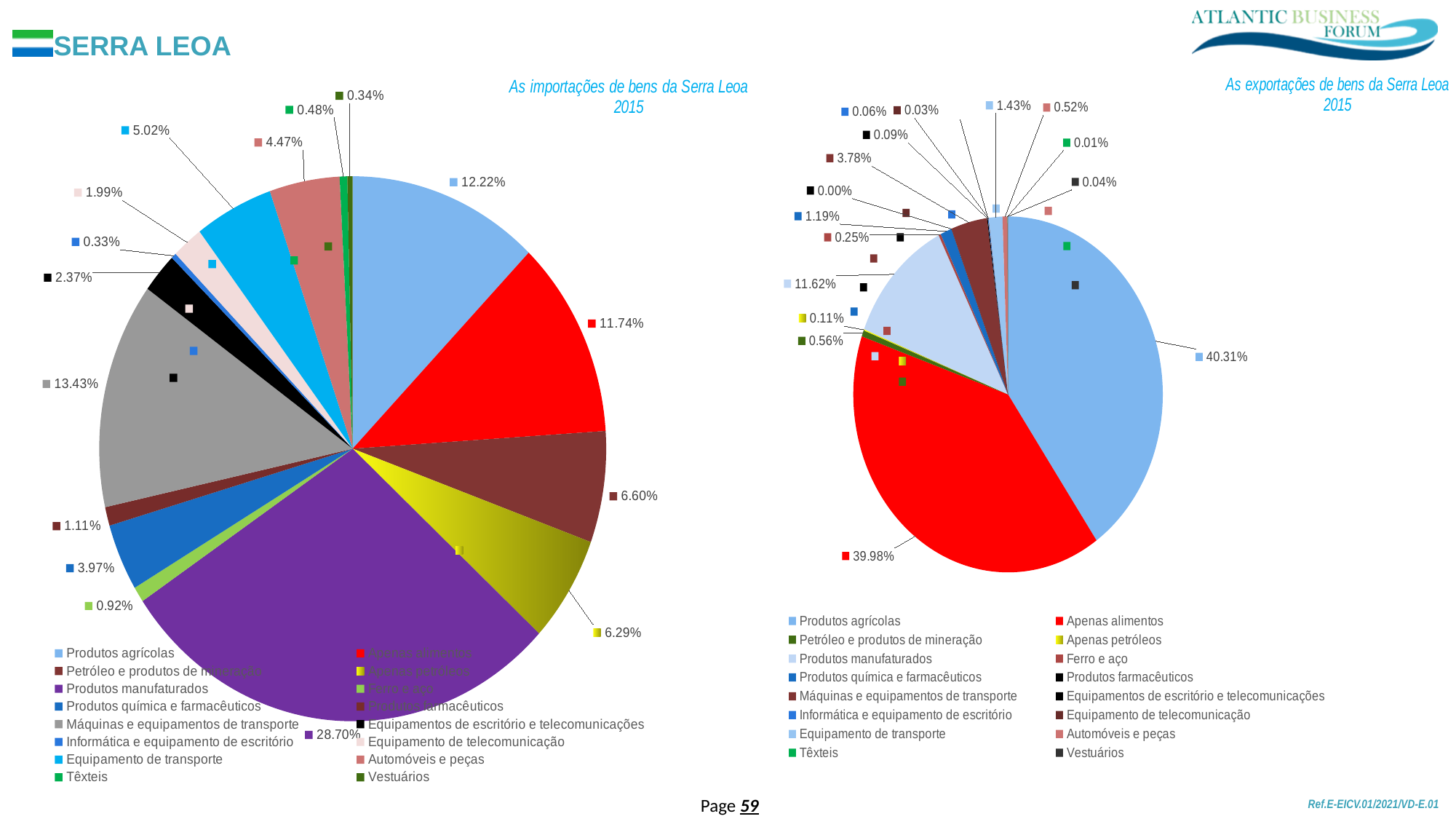
In the exports chart (right), what share is labelled for Produtos agrícolas? 40.31% How many entries does the legend of the imports chart (left) list? 16 What type of chart is used for 'As importações de bens da Serra Leoa 2015'? pie chart In the exports chart (right), what share is labelled for Apenas alimentos? 39.98% In the exports chart (right), what is the combined share of Produtos agrícolas (40.31%) and Apenas alimentos (39.98%)? 80.29% In the imports chart (left), which is larger: Equipamento de transporte or Automóveis e peças? Equipamento de transporte In the imports chart (left), what is the difference between the Produtos agrícolas slice (12.22%) and the Apenas alimentos slice (11.74%)? 0.48% In the imports chart (left), which category has the largest slice? Produtos manufaturados In the exports chart (right), what share is labelled for Produtos manufaturados? 11.62% In the imports chart (left), what share is labelled for Máquinas e equipamentos de transporte? 13.43% In the imports chart (left), what share is labelled for Produtos manufaturados? 28.70% What is the title of the chart on the right side of the slide? As exportações de bens da Serra Leoa 2015